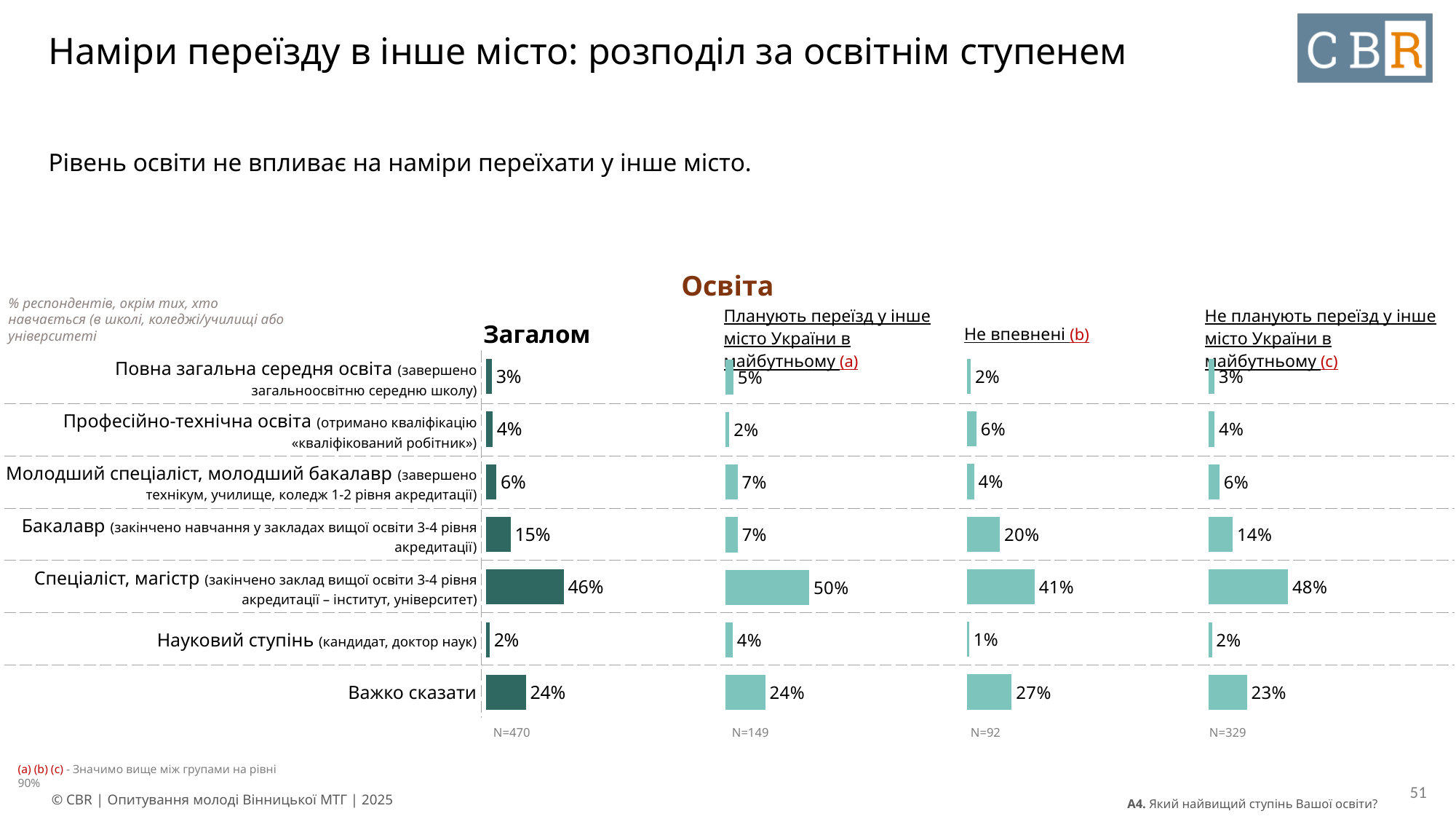
What type of chart is used for the "Загалом" data? Bar chart In the "Не впевнені (b)" chart, what is the value for "Бакалавр"? 20% In the "Не планують переїзд у інше місто України в майбутньому (c)" chart, what is the difference between "Спеціаліст, магістр" and "Бакалавр"? 34% How many categories are shown in the "Загалом" chart? 7 In the "Загалом" chart, what is the value for "Спеціаліст, магістр"? 46% In the "Загалом" chart, what is the difference between "Спеціаліст, магістр" and "Важко сказати"? 22% In the "Планують переїзд у інше місто України в майбутньому (a)" chart, what is the value for "Повна загальна середня освіта"? 5% What is the sample size (N) shown under the "Не впевнені (b)" chart? N=92 In the "Не впевнені (b)" chart, which category has the lowest value? Науковий ступінь In the "Планують переїзд у інше місто України в майбутньому (a)" chart, what is the value for "Важко сказати"? 24% In the "Не впевнені (b)" chart, which is larger: "Бакалавр" or "Професійно-технічна освіта"? Бакалавр In the "Не планують переїзд у інше місто України в майбутньому (c)" chart, which category has the highest value? Спеціаліст, магістр